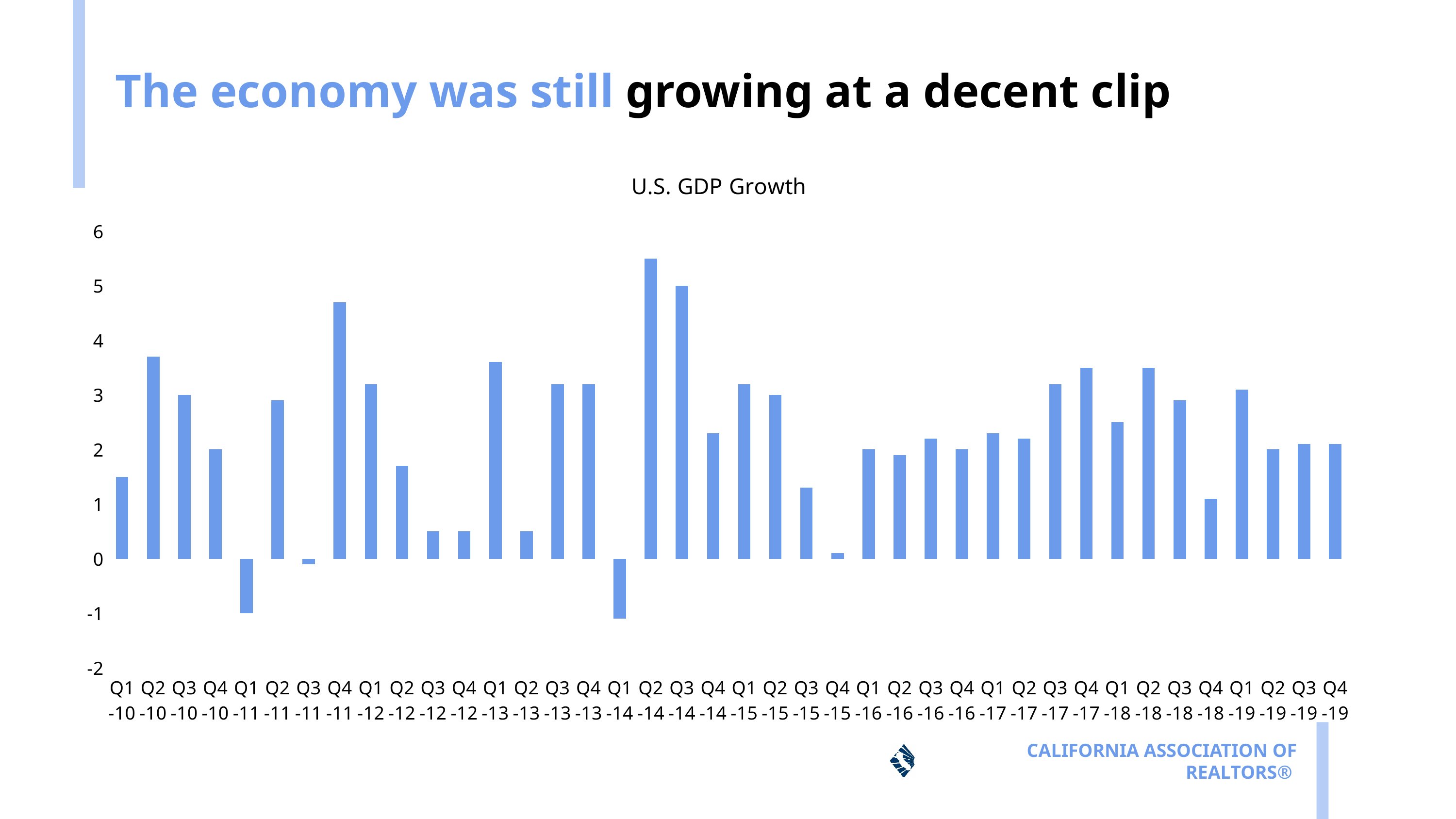
Which is larger, the value for Q4-11 or the value for Q1-12? Q4-11 What is the title of the chart? U.S. GDP Growth Is the value for Q4-17 greater or less than 3? greater How many quarterly bars are plotted in the U.S. GDP Growth chart? 40 Which quarter has the highest GDP growth in the chart? Q2-14 Is the value for Q3-12 greater or less than 1? less Which is larger, the value for Q1-10 or the value for Q2-10? Q2-10 What is the lowest value shown on the vertical axis of the chart? -2 What kind of chart is used to show U.S. GDP Growth? bar chart Is the value for Q2-14 greater or less than 5? greater